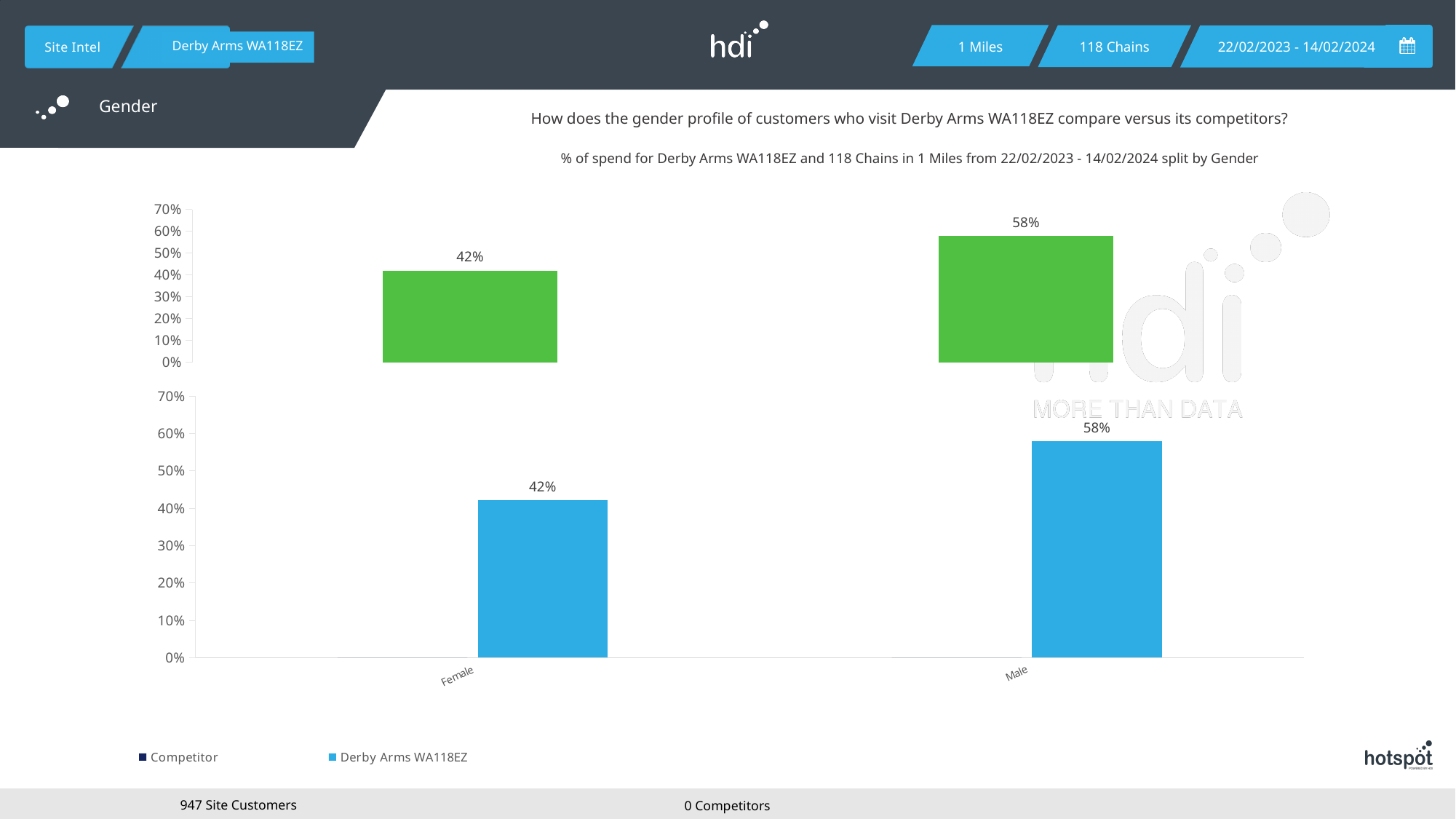
In the bottom blue bar chart, what is the difference between the Male and Female values? 16% In the bottom blue bar chart, is the value for Male greater or less than 50%? greater In the bottom blue bar chart, what is the value for Female? 42% In the top green bar chart, what is the value shown on the left-hand bar? 42% In the bottom blue bar chart, what is the value for Male? 58% In the bottom blue bar chart, which category has the lowest value? Female In the bottom blue bar chart, is the value for Female greater or less than 50%? less In the bottom blue bar chart, which category has the highest value? Male How many series does the legend at the bottom of the slide list? 2 In the top green bar chart, what is the value shown on the right-hand bar? 58% How many categories are shown on the x axis of the bottom blue bar chart? 2 What kind of chart is the bottom chart on the slide? bar chart